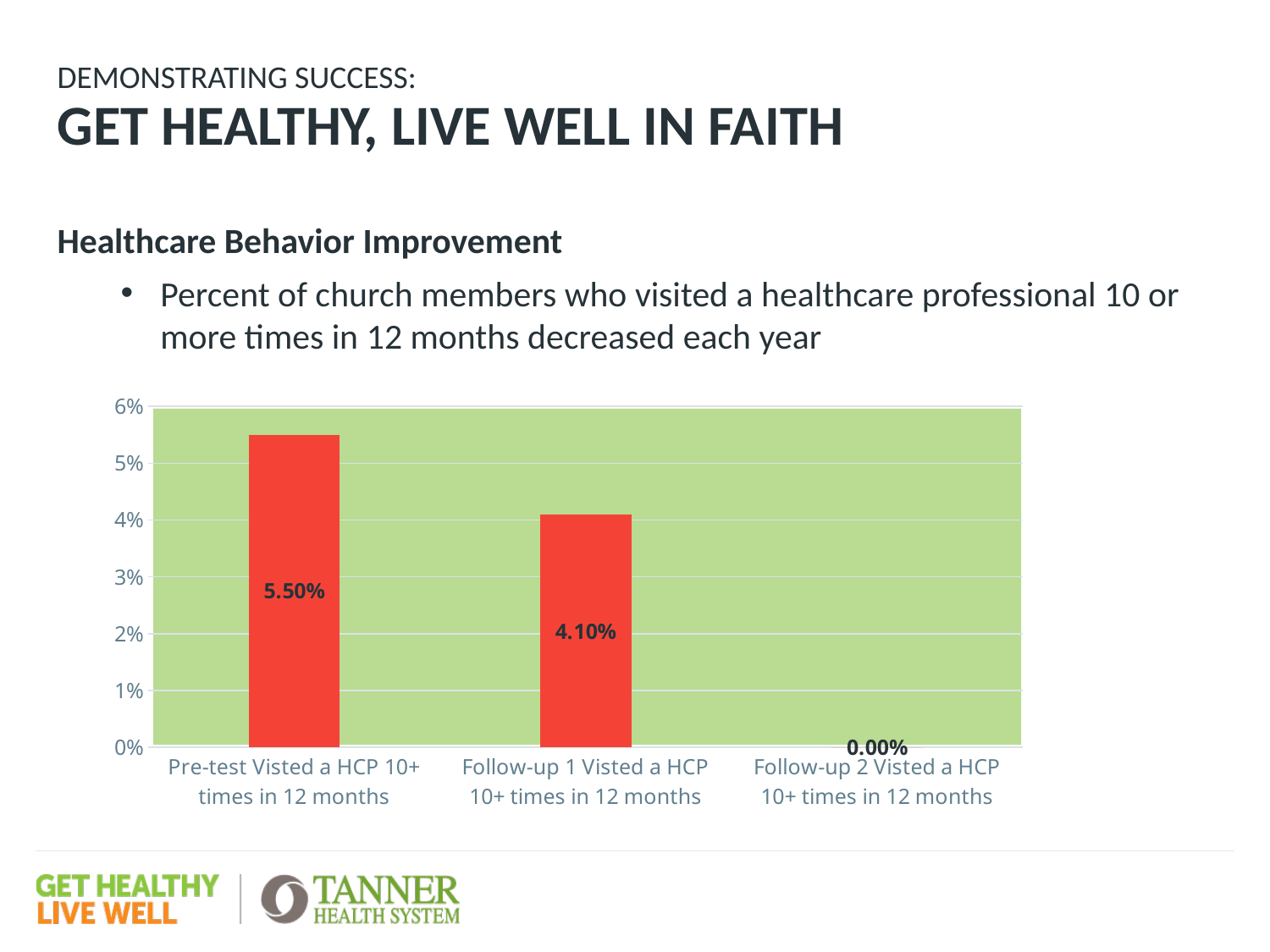
Which category has the highest value? Pre-test Visted a HCP 10+ times in 12 months Which is larger, the value for Pre-test or the value for Follow-up 1? Pre-test What is the difference between the Pre-test value and the Follow-up 1 value? 1.40% What is the value for Pre-test Visted a HCP 10+ times in 12 months? 5.50% Do the values rise or fall from Pre-test to Follow-up 2? Fall How many categories are shown on the chart? 3 What kind of chart is shown on the slide? Bar chart Is the value for Pre-test Visted a HCP 10+ times in 12 months greater or less than 5%? greater Which category has the lowest value? Follow-up 2 Visted a HCP 10+ times in 12 months What is the value for Follow-up 1 Visted a HCP 10+ times in 12 months? 4.10% What is the value for Follow-up 2 Visted a HCP 10+ times in 12 months? 0.00% What is the highest value shown on the vertical axis? 6%